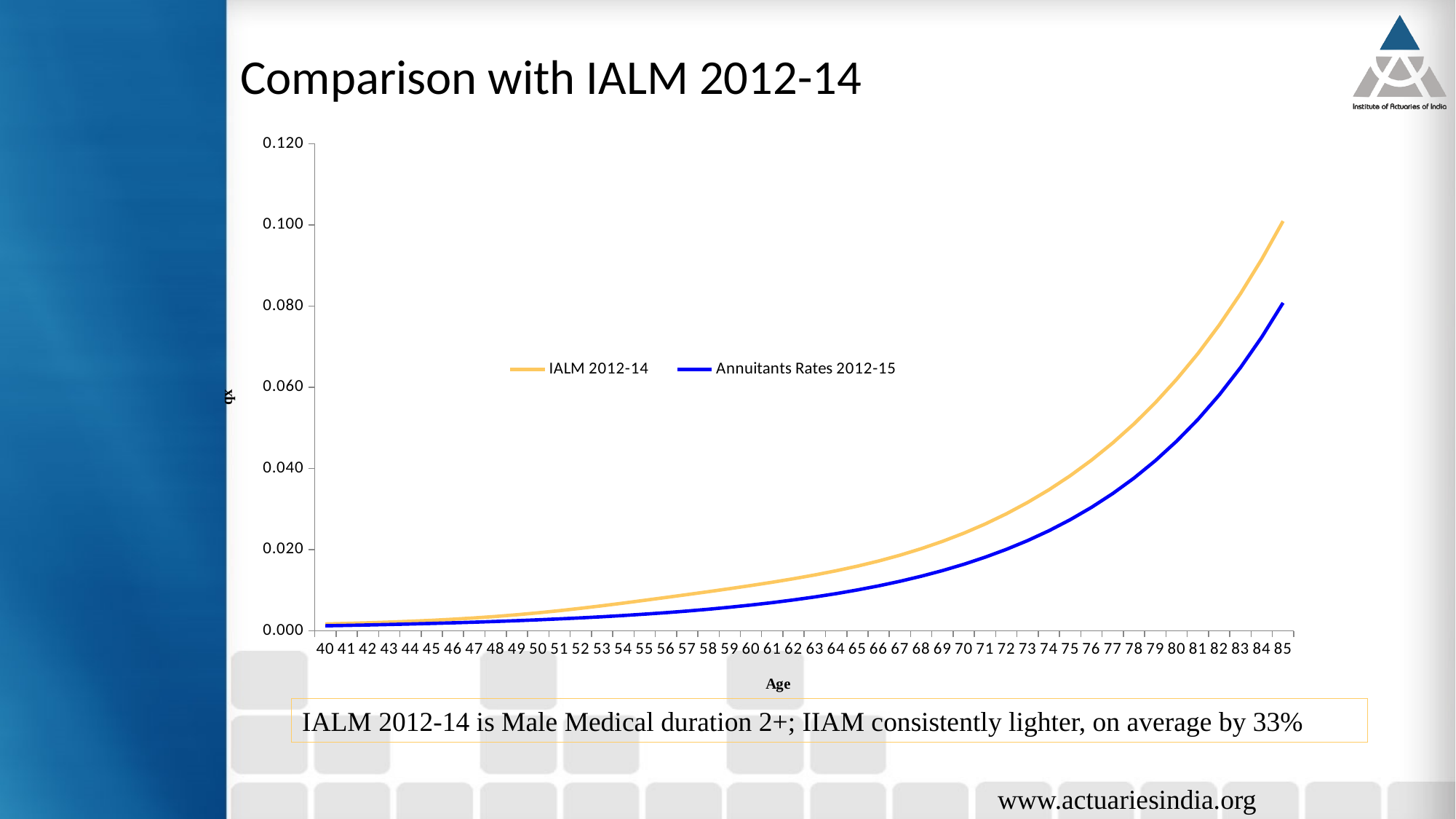
Is the value for Annuitants Rates 2012-15 at age 70 greater or less than 0.020? less What kind of chart is shown on the slide? Line chart Do the values of the IALM 2012-14 series rise or fall as age increases? Rise Which series is lower across the whole age range? Annuitants Rates 2012-15 Is the value for IALM 2012-14 at age 85 greater or less than 0.080? greater Is the value for Annuitants Rates 2012-15 at age 85 greater or less than 0.100? less How many series does the chart's legend list? 2 How many age points are plotted along the x axis (from 40 to 85)? 46 What is the label on the x axis of the chart? Age Which series has the higher value at age 85, IALM 2012-14 or Annuitants Rates 2012-15? IALM 2012-14 What are the two series named in the legend? IALM 2012-14 and Annuitants Rates 2012-15